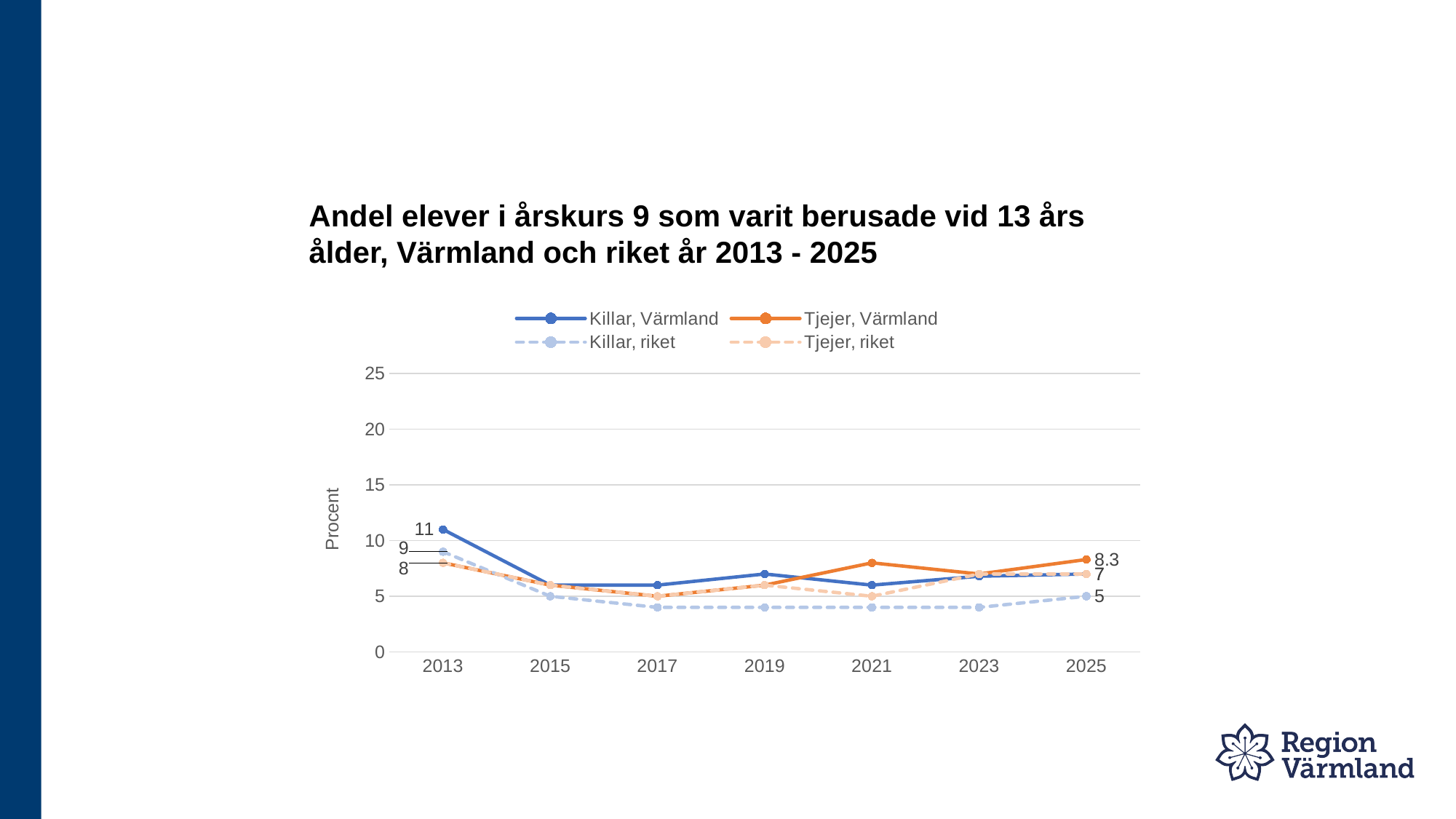
Does the Killar, Värmland line rise or fall from 2013 to 2017? fall What is the label on the y axis? Procent Which series has the highest value in 2025? Tjejer, Värmland How many series does the legend list? 4 What is the value for Tjejer, Värmland in 2025? 8.3 Which series has the lowest value in 2025? Killar, riket What is the value for Killar, Värmland in 2013? 11 What kind of chart is shown on the slide? line chart What is the value for Killar, riket in 2025? 5 Which series has the highest value in 2013? Killar, Värmland Is the value for Killar, riket in 2021 greater or less than 5? less How many years are shown on the x axis? 7